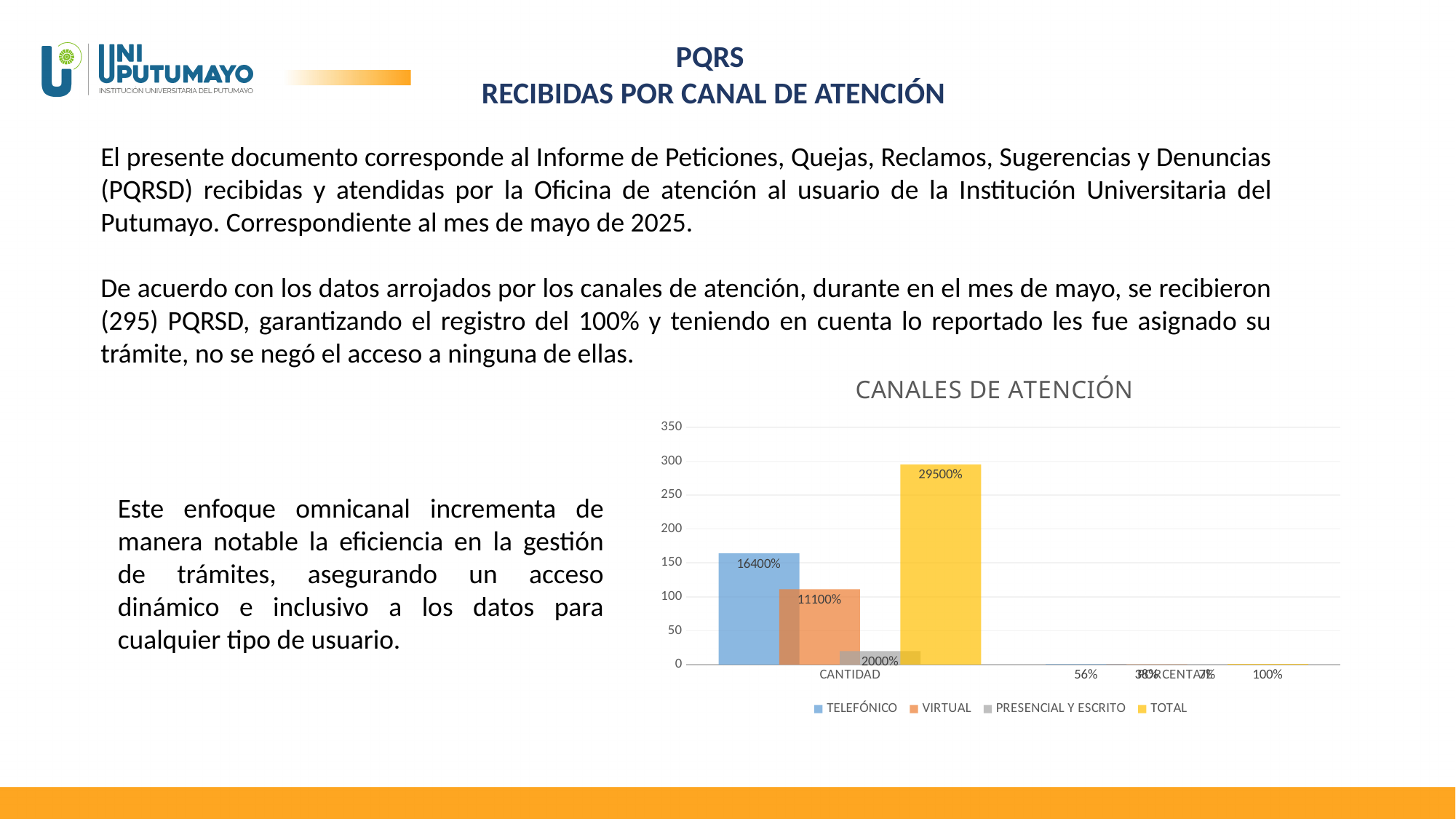
How many series does the chart legend list? 4 What is the data label for TELEFÓNICO in the CANTIDAD group? 16400% Which series has the tallest bar in the CANTIDAD group? TOTAL What is the title of the chart? CANALES DE ATENCIÓN What is the difference between the TELEFÓNICO and VIRTUAL data labels in the CANTIDAD group? 5300% What is the data label for TOTAL in the CANTIDAD group? 29500% What is the data label for VIRTUAL in the CANTIDAD group? 11100% What kind of chart is shown on the slide? bar chart In the CANTIDAD group, which bar is taller: TELEFÓNICO or VIRTUAL? TELEFÓNICO What is the data label for PRESENCIAL Y ESCRITO in the CANTIDAD group? 2000% Which series has the shortest bar in the CANTIDAD group? PRESENCIAL Y ESCRITO Is the TOTAL bar in the CANTIDAD group greater or less than 250 on the axis? greater